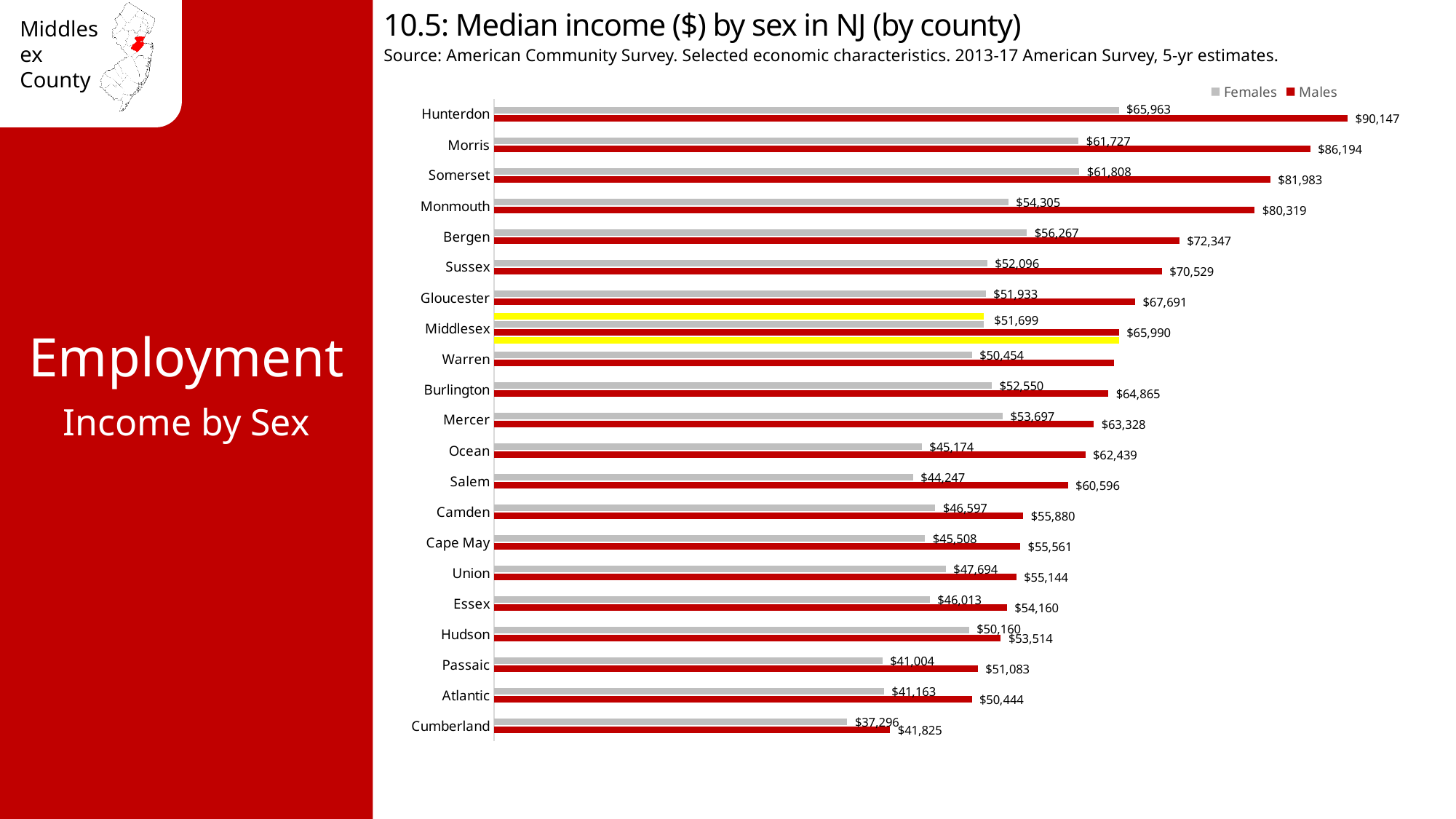
What is the difference between male and female median income in Hunterdon County? $24,184 What kind of chart is shown on the slide? Bar chart What is the difference between male and female median income in Middlesex County? $14,291 What is the median income for females in Middlesex County? $51,699 Which county's bars are highlighted in yellow? Middlesex What is the median income for males in Hunterdon County? $90,147 How many counties are shown in the chart? 21 Which is larger: the female median income in Bergen County or in Monmouth County? Bergen Which county has the lowest median income for males? Cumberland What is the median income for males in Cumberland County? $41,825 How many series does the legend list? 2 Which county has the highest median income for females? Hunterdon